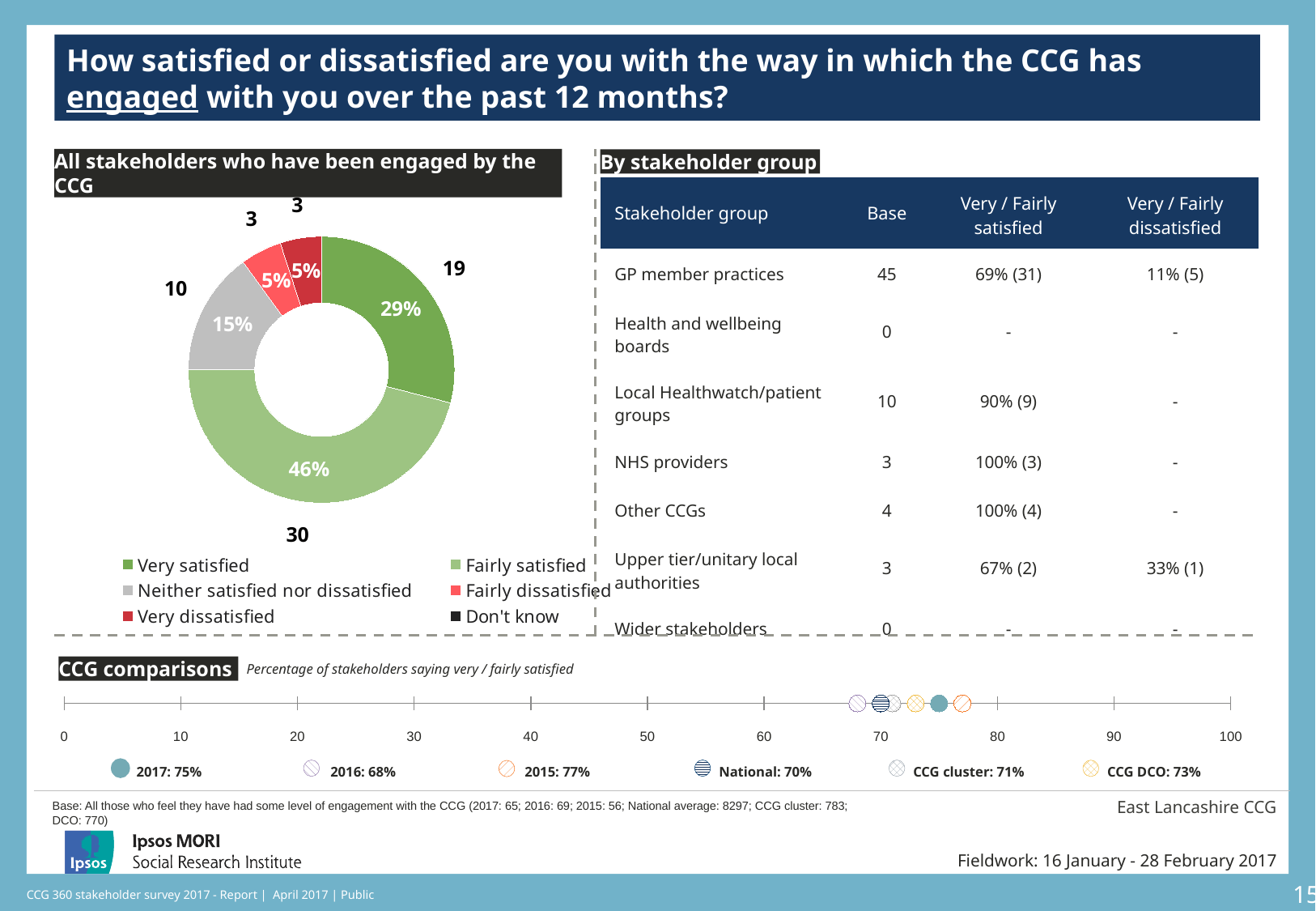
In the donut chart for all stakeholders engaged by the CCG, how many respondents were fairly satisfied according to the count label? 30 What type of chart is used for all stakeholders who have been engaged by the CCG? Donut chart In the donut chart for all stakeholders engaged by the CCG, what percentage were very satisfied? 29% In the donut chart for all stakeholders engaged by the CCG, which is larger: the share neither satisfied nor dissatisfied or the share fairly dissatisfied? Neither satisfied nor dissatisfied In the donut chart for all stakeholders engaged by the CCG, what percentage were fairly satisfied? 46% In the CCG comparisons chart, which marker shows the highest percentage? 2015: 77% In the donut chart for all stakeholders engaged by the CCG, what percentage were neither satisfied nor dissatisfied? 15% In the donut chart for all stakeholders engaged by the CCG, which response category has the largest share? Fairly satisfied In the donut chart for all stakeholders engaged by the CCG, what is the difference in percentage points between fairly satisfied and very satisfied? 17 In the CCG comparisons chart, what percentage of stakeholders said very / fairly satisfied in 2017? 75% How many entries does the legend of the donut chart for all stakeholders engaged by the CCG list? 6 In the CCG comparisons chart, what is the difference in percentage points between 2017 and 2016? 7